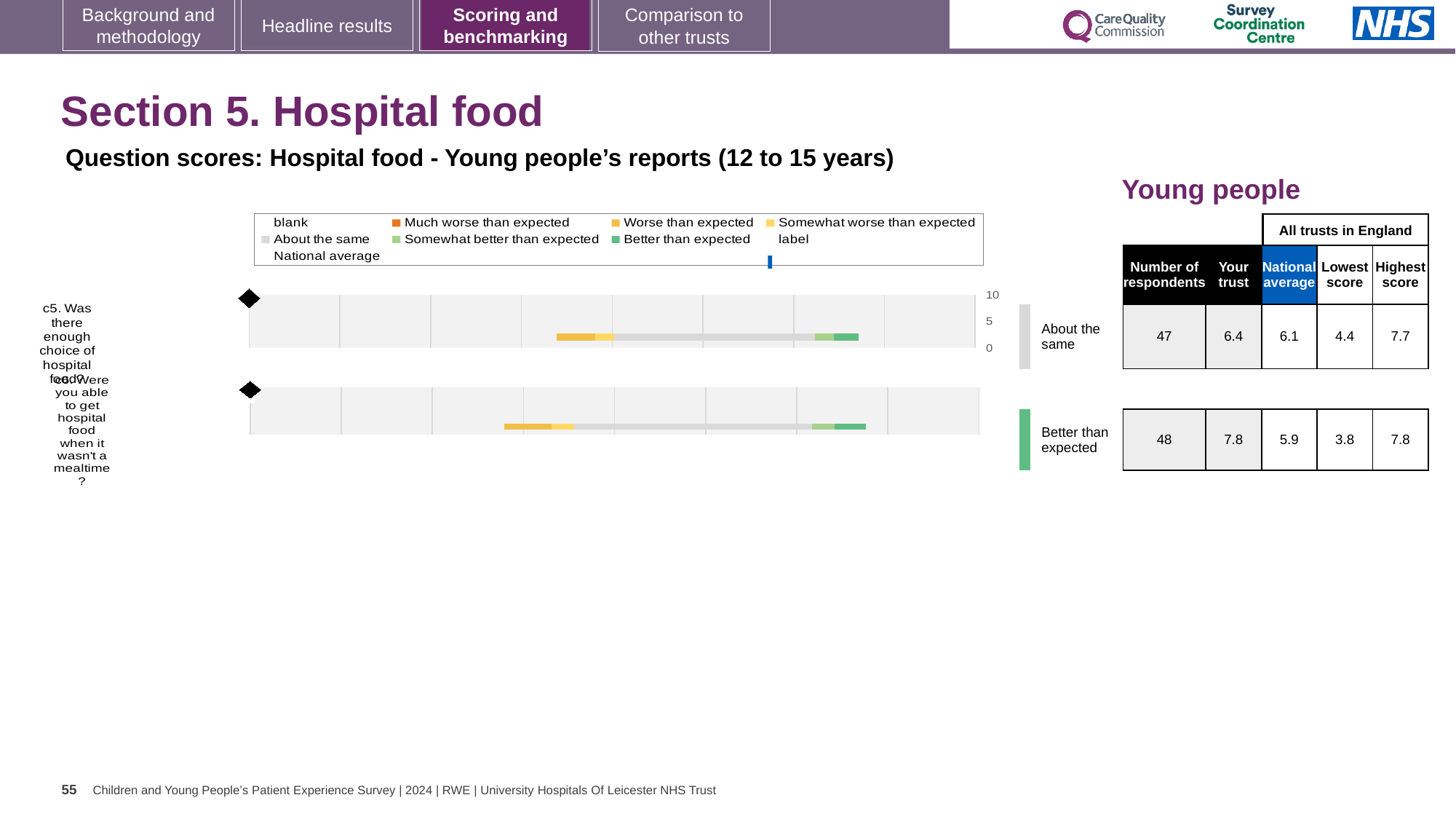
What is the highest value shown on the chart's score axis? 10 By how much does the trust's score for c6 exceed the national average? 1.9 What kind of chart is used to show the question scores for hospital food? bar chart According to the table beside the chart, what is the national average for c5 (enough choice of hospital food)? 6.1 Which benchmark category is assigned to c6 (getting hospital food when it wasn't a mealtime)? Better than expected How many survey questions are plotted in the hospital food chart? 2 According to the table beside the chart, what is the trust's score for c6 (getting hospital food when it wasn't a mealtime)? 7.8 According to the table beside the chart, how many respondents answered c5 (enough choice of hospital food)? 47 According to the table beside the chart, what is the lowest score across all trusts in England for c6? 3.8 In the chart legend, which category is shown in orange? Much worse than expected Which question has the higher trust score, c5 or c6? c6 What is the difference between the highest and lowest trust scores in England for c5? 3.3